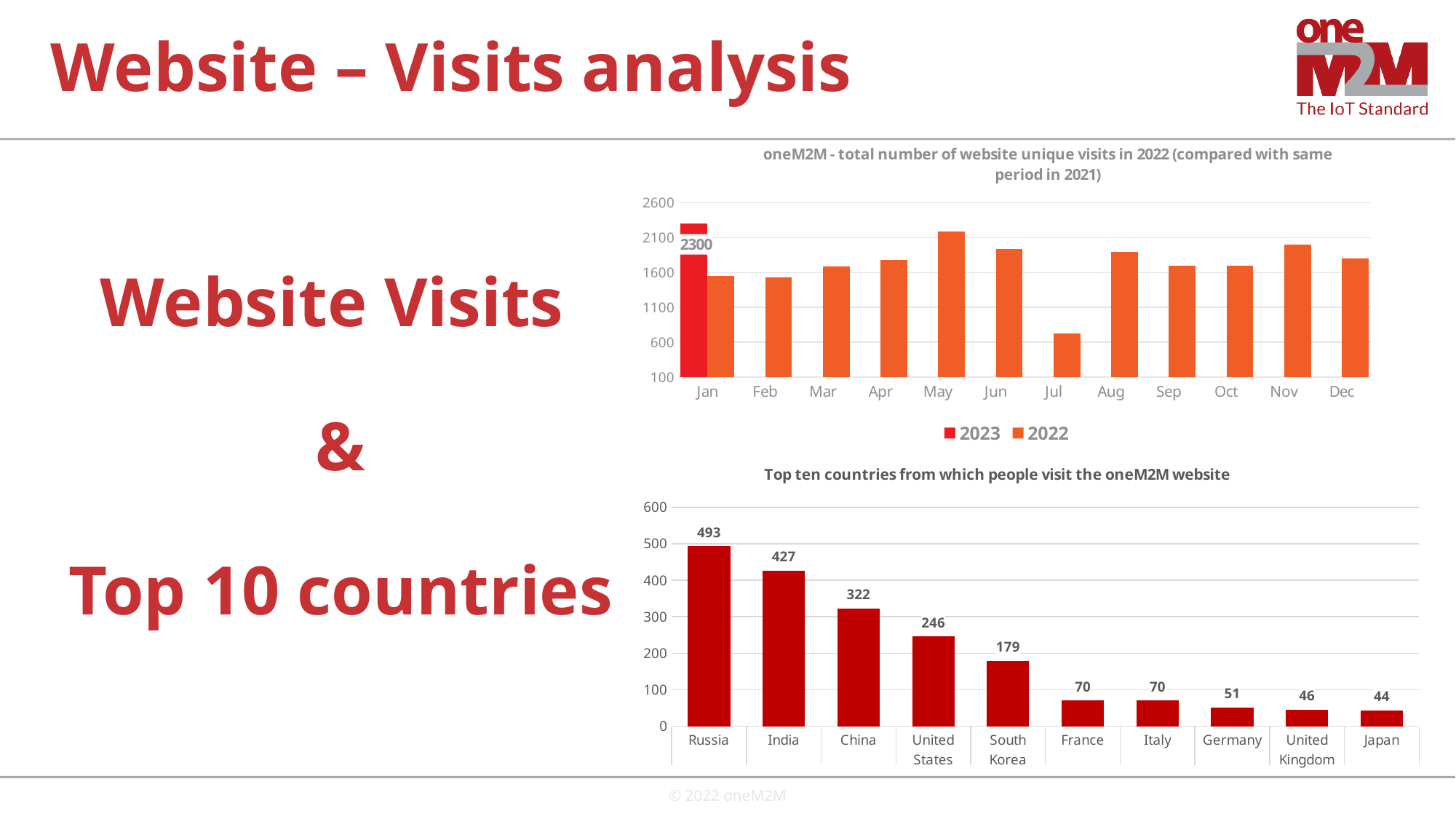
What kind of chart is the bottom chart (Top ten countries)? bar chart In the top chart (oneM2M total number of website unique visits), which month has the highest 2022 value? May In the bottom chart (Top ten countries), what is the value for Russia? 493 In the bottom chart (Top ten countries), what is the difference between the values for Russia and India? 66 In the top chart (oneM2M total number of website unique visits), how many series does the legend list? 2 In the bottom chart (Top ten countries), what is the value for Japan? 44 In the top chart (oneM2M total number of website unique visits), is the 2022 value for Jul greater or less than 1100? less In the bottom chart (Top ten countries), which country has the highest value? Russia In the top chart (oneM2M total number of website unique visits), which month has the lowest 2022 value? Jul In the top chart (oneM2M total number of website unique visits), how many months are shown on the x axis? 12 In the top chart (oneM2M total number of website unique visits), what is the value for 2023 in Jan? 2300 In the bottom chart (Top ten countries), which is larger, the value for China or the value for United States? China